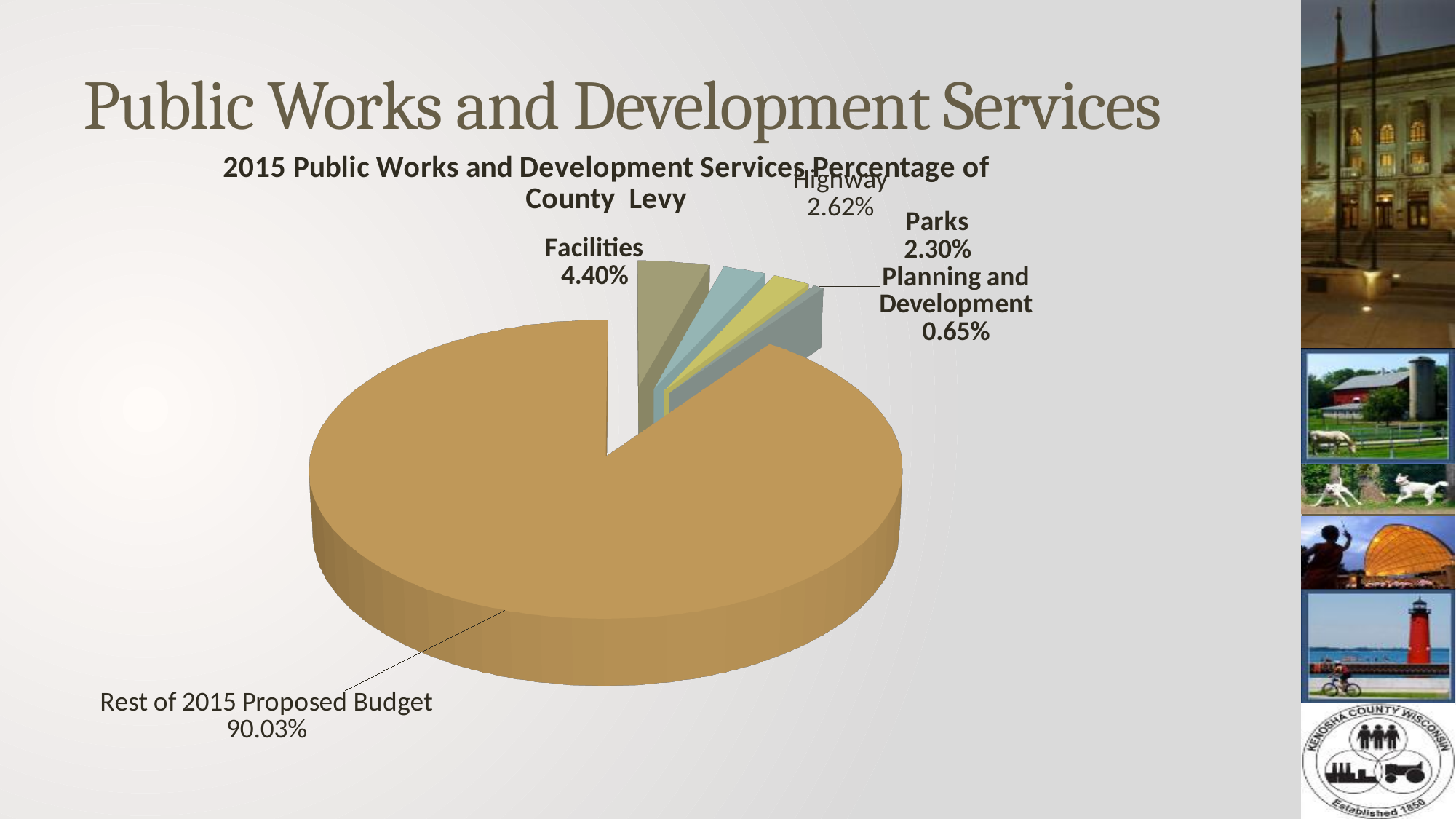
What percentage of the county levy does Facilities account for? 4.40% What percentage is shown for Planning and Development? 0.65% What is the title of the chart? 2015 Public Works and Development Services Percentage of County Levy Which slice of the pie is the largest? Rest of 2015 Proposed Budget Which is larger, the Facilities slice or the Highway slice? Facilities What percentage is shown for Parks? 2.30% What percentage is shown for Highway? 2.62% How many slices does the pie chart have? 5 What is the difference in percentage points between Facilities and Parks? 2.10% What percentage is labelled for Rest of 2015 Proposed Budget? 90.03% What kind of chart is shown on the slide? Pie chart Which slice of the pie is the smallest? Planning and Development